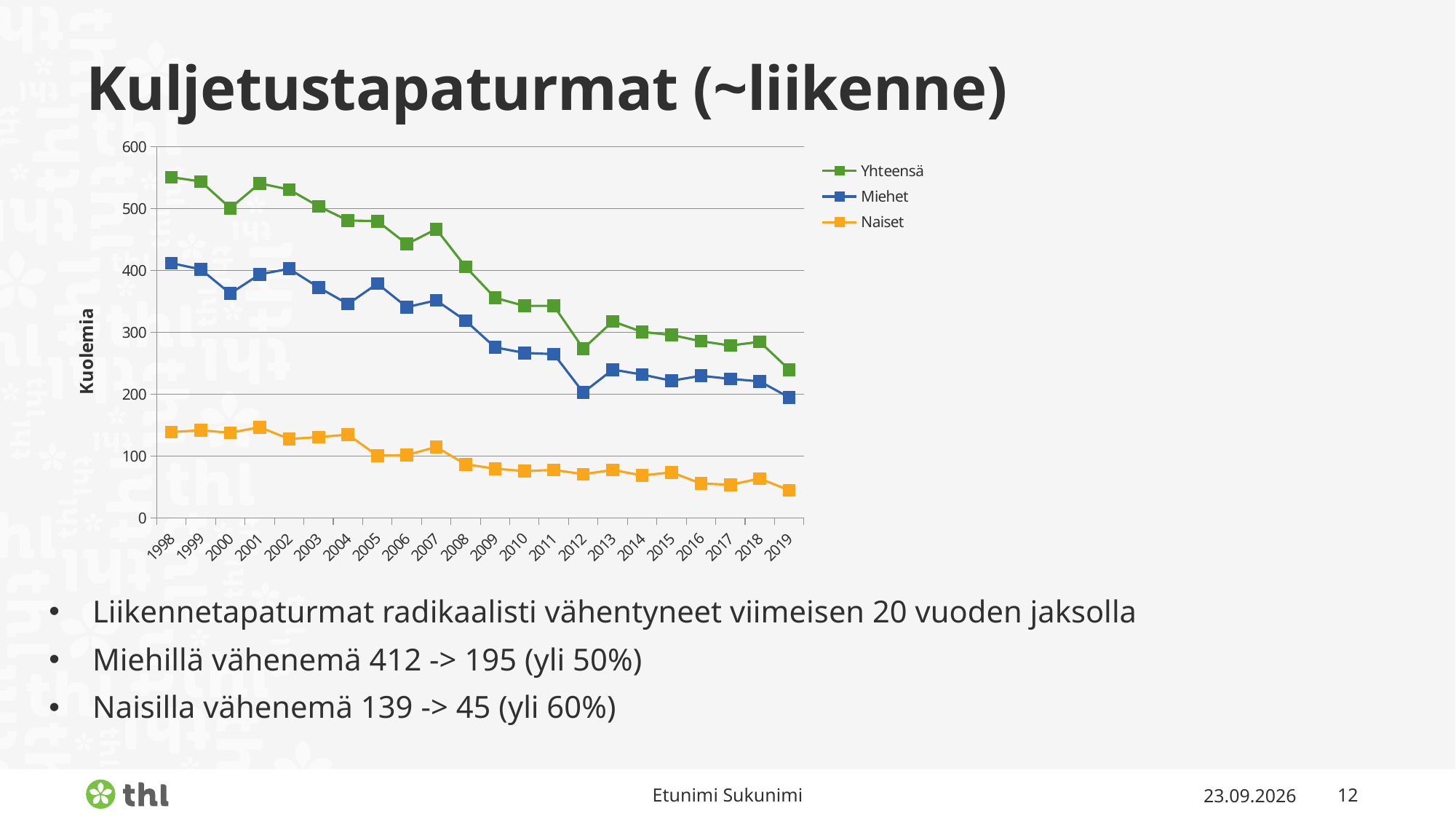
How many years are plotted along the x axis of the chart? 22 What is the value for Naiset in 1998? 139 How many series does the chart legend list? 3 Is the value for Yhteensä in 2019 greater or less than 300? less What is the value for Miehet in 1998? 412 By how much did the Miehet value fall from 1998 to 2019? 217 By how much did the Naiset value fall from 1998 to 2019? 94 What is the value for Naiset in 2019? 45 What kind of chart is shown on the slide? line chart Do the Yhteensä values generally rise or fall from 1998 to 2019? fall What is the value for Miehet in 2019? 195 Is the value for Yhteensä in 1998 greater or less than 500? greater